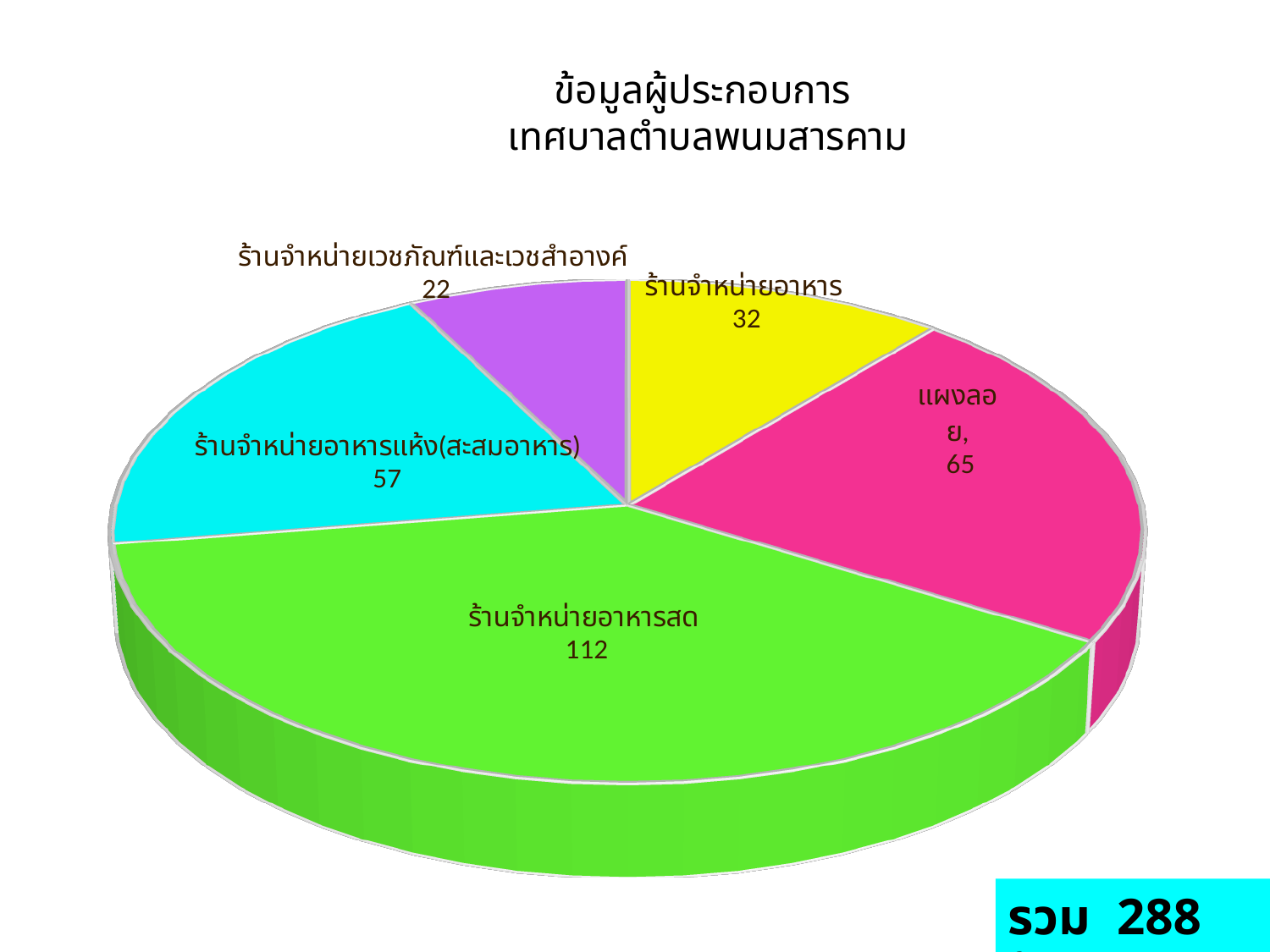
What is the difference between the values for ร้านจำหน่ายอาหารสด and แผงลอย? 47 Which category has the smallest slice of the pie? ร้านจำหน่ายเวชภัณฑ์และเวชสำอางค์ What colour is the slice for ร้านจำหน่ายอาหารสด? Green What is the value for ร้านจำหน่ายเวชภัณฑ์และเวชสำอางค์? 22 What kind of chart is shown on the slide? Pie chart How many categories (slices) does the pie chart have? 5 What is the value for ร้านจำหน่ายอาหารสด? 112 Which is larger, the value for ร้านจำหน่ายอาหาร or the value for ร้านจำหน่ายอาหารแห้ง(สะสมอาหาร)? ร้านจำหน่ายอาหารแห้ง(สะสมอาหาร) Which category has the largest slice of the pie? ร้านจำหน่ายอาหารสด What is the value for ร้านจำหน่ายอาหารแห้ง(สะสมอาหาร)? 57 What is the value for แผงลอย? 65 What total is shown on the slide for all categories combined? 288